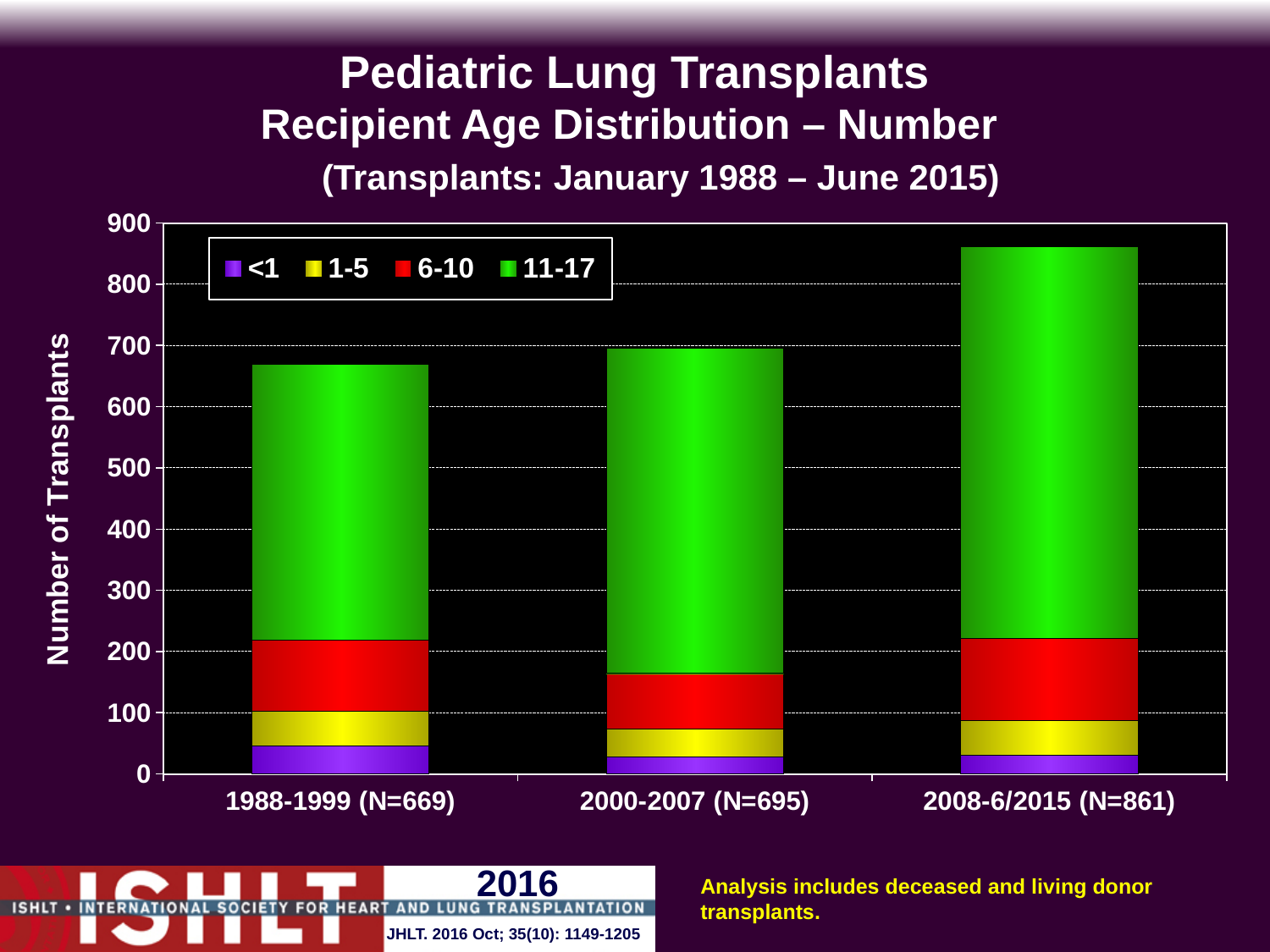
How many era categories are shown on the x axis? 3 Which era has a larger total number of transplants, 1988-1999 or 2000-2007? 2000-2007 Which era has the lowest total number of transplants? 1988-1999 How many age groups does the legend list? 4 Which era has the highest total number of transplants? 2008-6/2015 What is the total number of transplants (N) for the 2008-6/2015 era? 861 Is the combined height of the <1, 1-5 and 6-10 segments for 2000-2007 greater or less than 200? less What is the total number of transplants (N) for the 2000-2007 era? 695 Do the total numbers of transplants rise or fall across the eras from left to right? Rise What is the difference between the total number of transplants in 2008-6/2015 and in 1988-1999? 192 What is the total number of transplants (N) for the 1988-1999 era? 669 What kind of chart is shown on the slide? Stacked bar chart